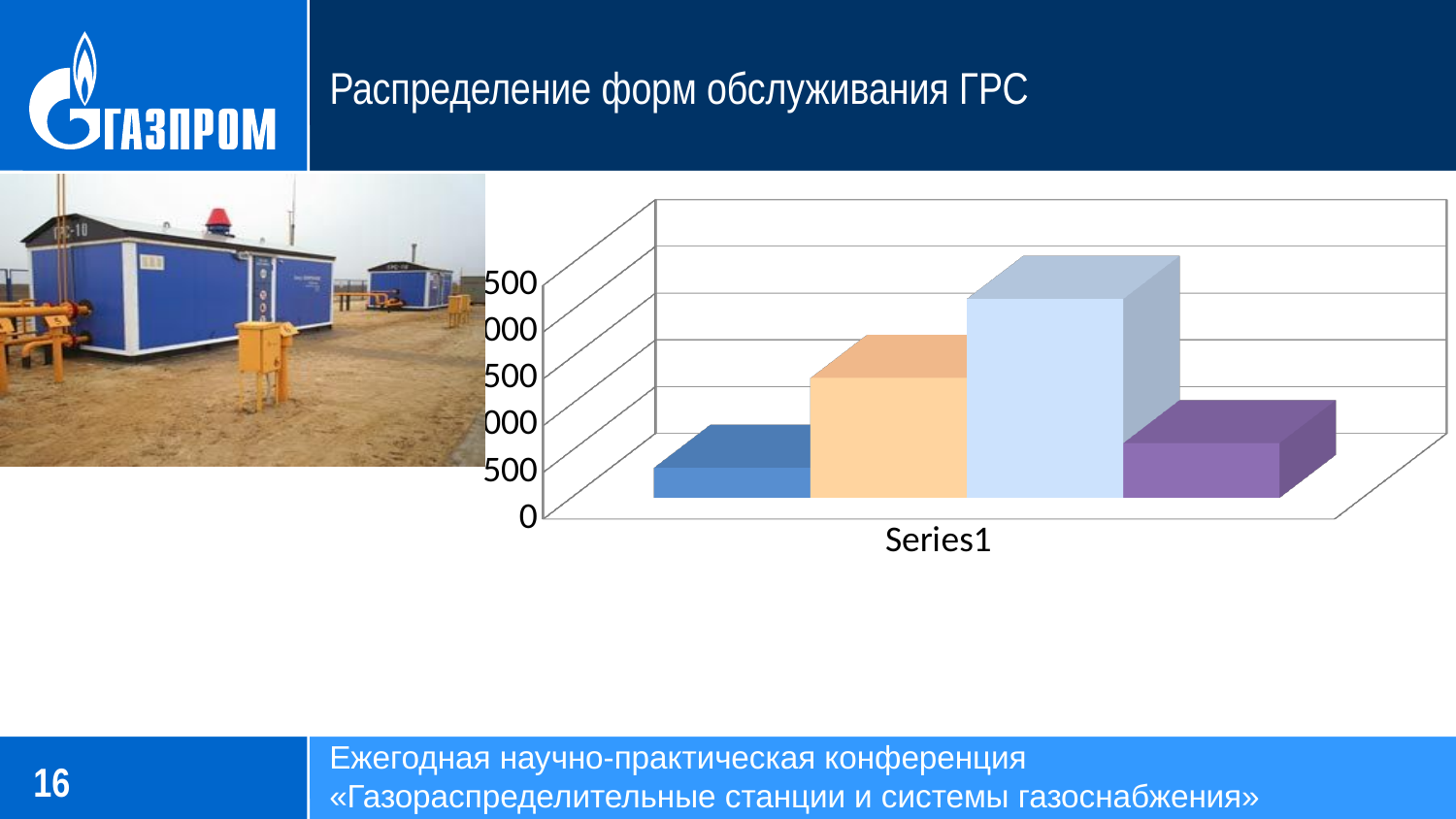
Which is larger, the orange bar or the purple bar? the orange bar Which bar is the shortest in the chart? the first (dark blue) bar Which bar is the tallest in the chart? the third (light blue) bar Which is larger, the light blue bar or the orange bar? the light blue bar What label is shown on the horizontal axis of the chart? Series1 Is the value of the orange bar greater or less than 1000? greater Is the value of the light blue bar greater or less than 1500? greater How many bars are plotted in the chart? 4 Is the value of the purple bar greater or less than 1500? less What is the title of the slide containing the chart? Распределение форм обслуживания ГРС What kind of chart is shown on the slide? bar chart